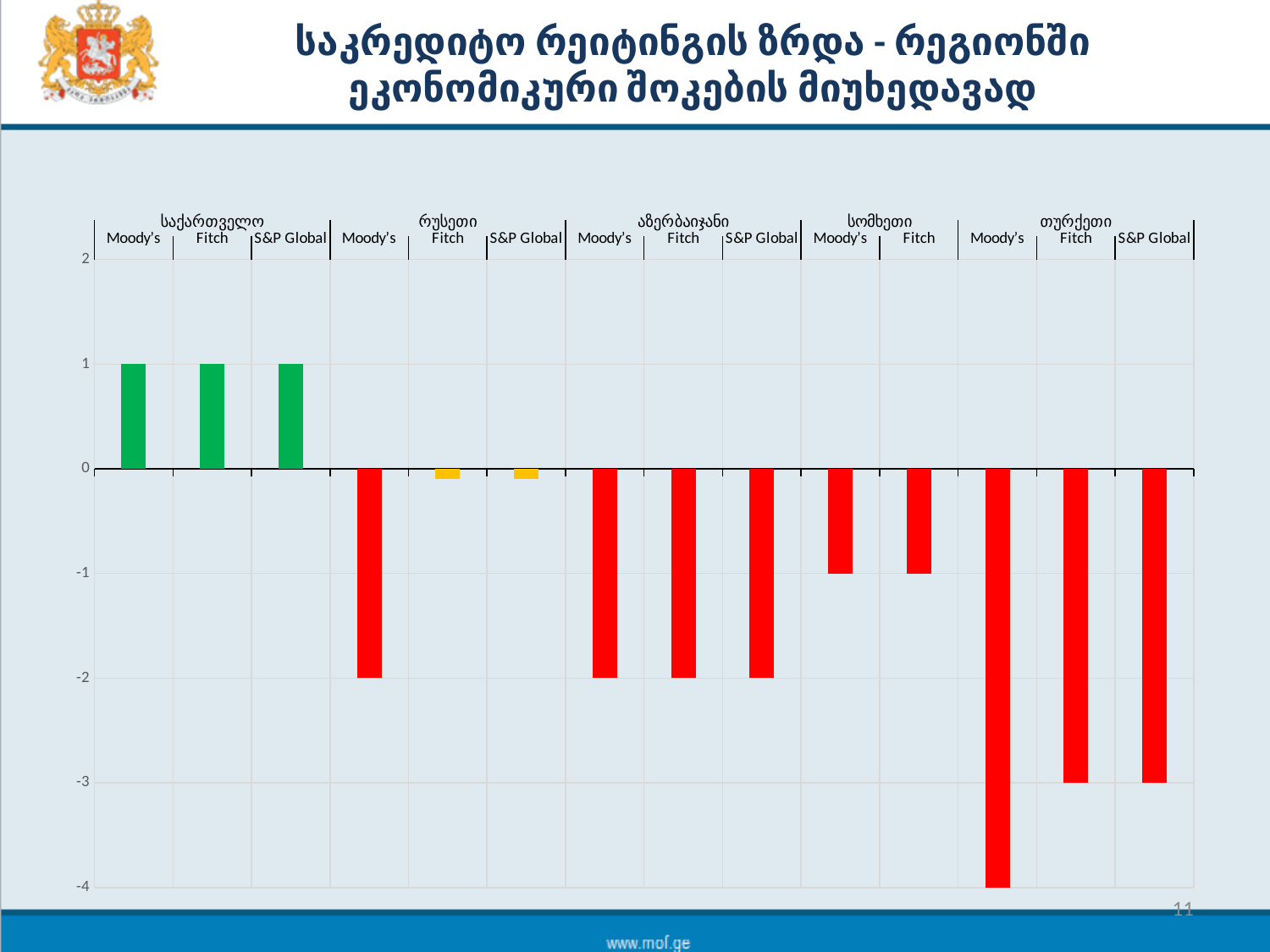
How many country groups are shown on the chart? 5 What kind of chart is shown on the slide? bar chart What is the value of the Moody's bar for საქართველო? 1 What is the value of the S&P Global bar for თურქეთი? -3 Which bar has the lowest value on the chart? Moody's for თურქეთი What is the value of the Fitch bar for სომხეთი? -1 What colour are the bars for საქართველო? green Is the Fitch value for რუსეთი greater or less than -1? greater What is the difference between the Fitch value for საქართველო and the Fitch value for აზერბაიჯანი? 3 What is the value of the Moody's bar for თურქეთი? -4 How many bars are plotted on the chart in total? 14 Which is larger, the Moody's value for რუსეთი or the Moody's value for სომხეთი? სომხეთი